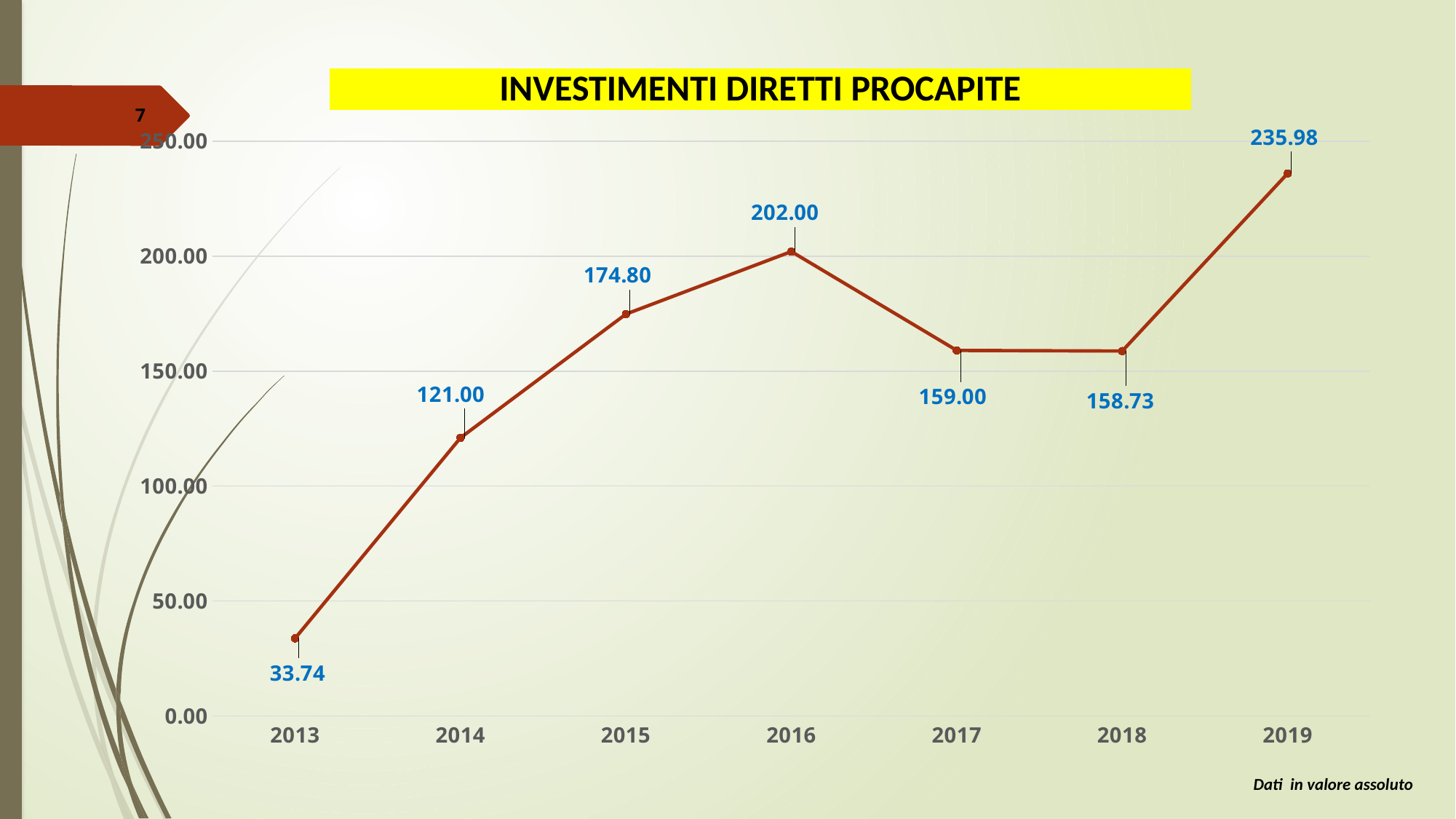
What is the difference between the values for 2014 and 2013? 87.26 What is the title of the chart? INVESTIMENTI DIRETTI PROCAPITE Which year has the lowest value? 2013 Is the value for 2014 greater or less than 100.00? greater What kind of chart is shown on the slide? line chart What is the value for 2018? 158.73 What is the value for 2016? 202.00 Which year has the highest value? 2019 Which is larger, the value for 2015 or the value for 2017? 2015 How many years are plotted on the chart? 7 What is the value for 2013? 33.74 What is the difference between the values for 2019 and 2016? 33.98